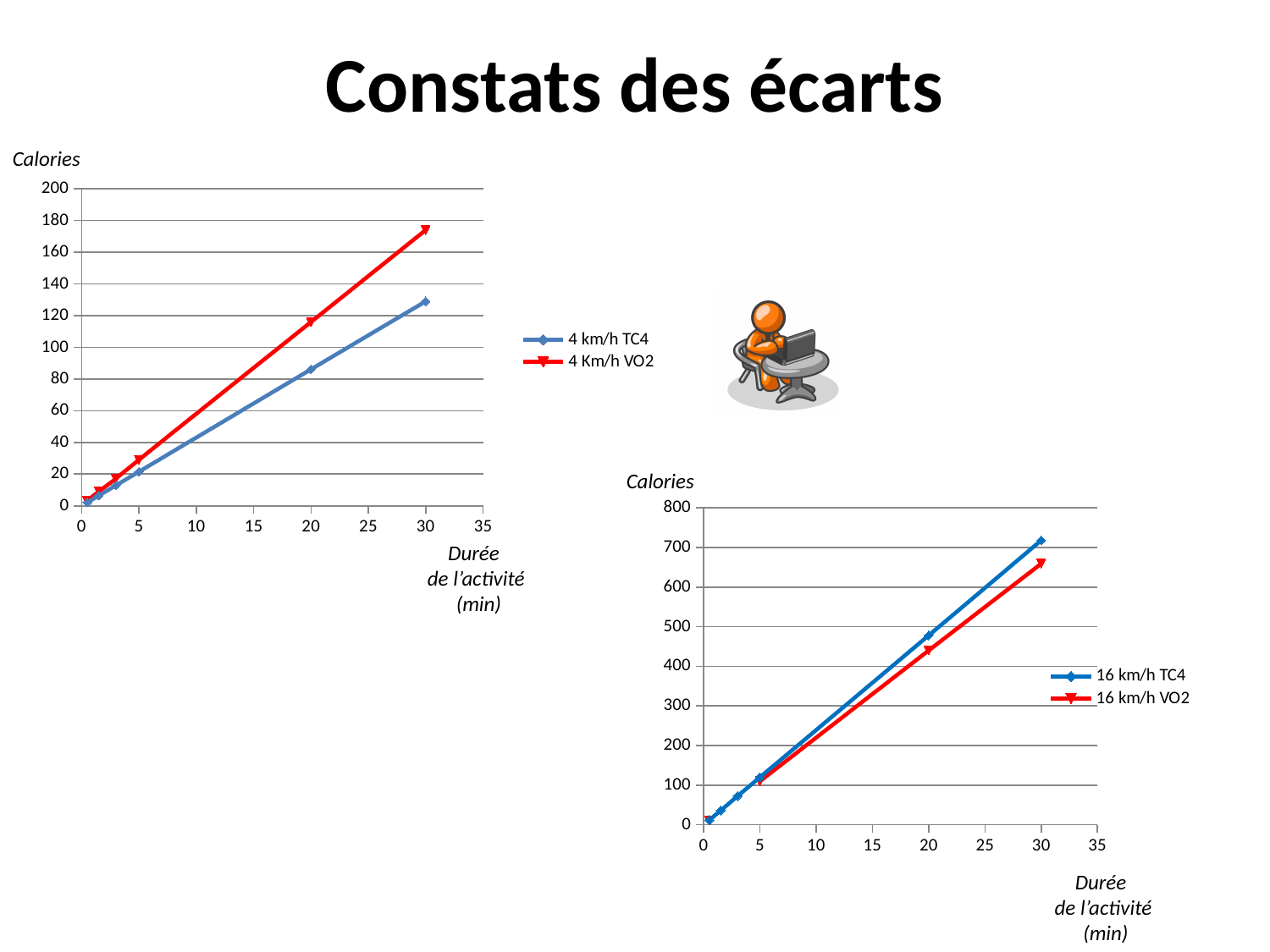
In the left chart, do the values for 4 Km/h VO2 rise or fall as the duration increases? rise In the left chart, is the value for 4 km/h TC4 at 30 minutes greater or less than 140? less In the left chart, which series has the higher value at 30 minutes, 4 km/h TC4 or 4 Km/h VO2? 4 Km/h VO2 In the left chart, is the value for 4 Km/h VO2 at 30 minutes greater or less than 160? greater In the right chart, which series has the higher value at 30 minutes, 16 km/h TC4 or 16 km/h VO2? 16 km/h TC4 In the right chart, is the value for 16 km/h TC4 at 20 minutes greater or less than 400? greater How many series does the legend of the left chart list? 2 What is the label of the vertical axis of the left chart? Calories How many series does the legend of the right chart list? 2 What kind of chart is the chart on the left of the slide? line chart In the right chart, do the values for 16 km/h TC4 rise or fall as the duration increases? rise